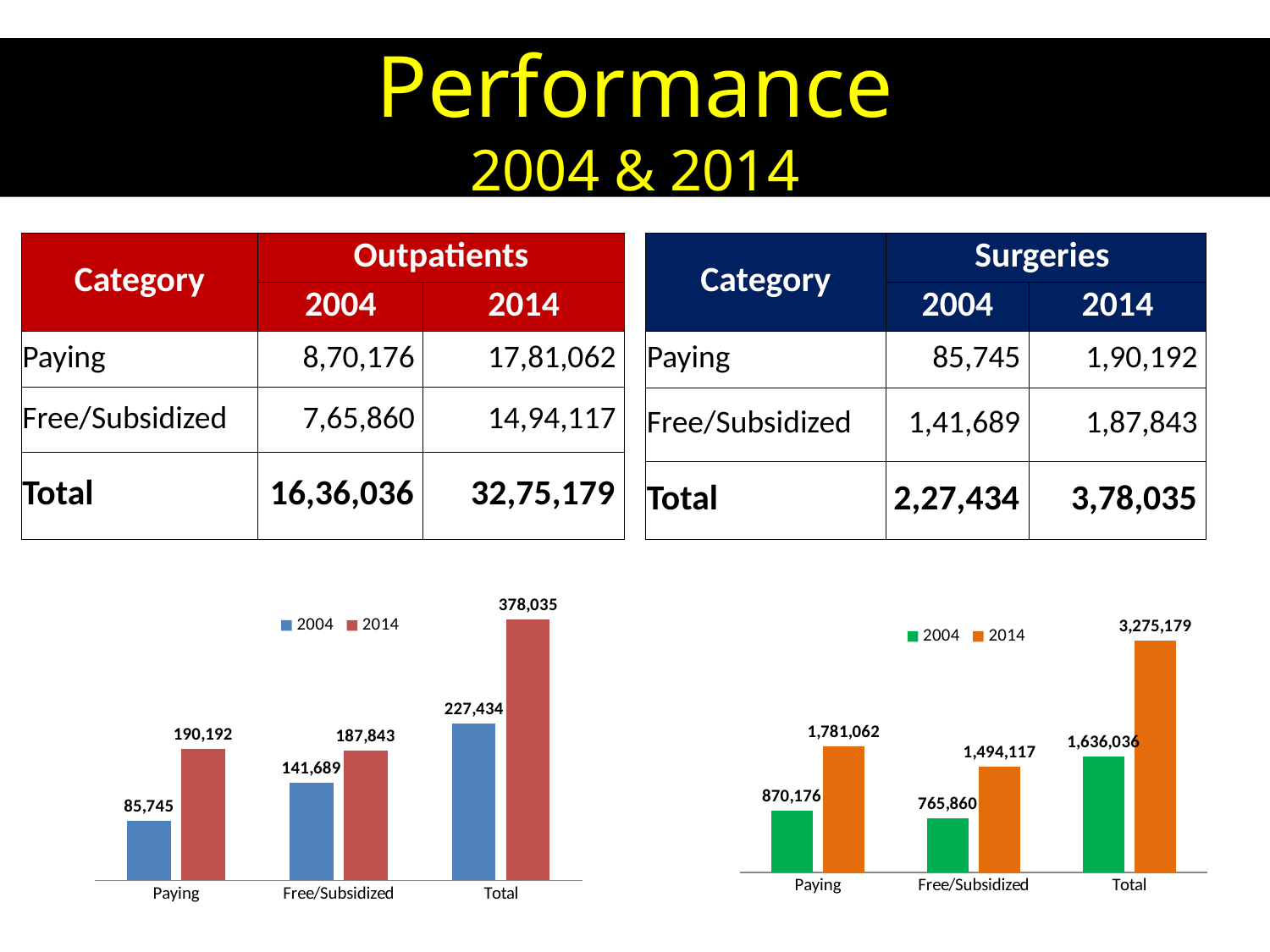
In the left chart, which is larger for 2004: Paying or Free/Subsidized? Free/Subsidized In the right chart, what is the value of the 2014 bar for Paying? 1,781,062 What type of chart is the right chart? Bar chart In the right chart, which category has the highest 2014 value? Total In the right chart, what is the difference between the 2014 and 2004 values for Paying? 910,886 In the left chart, what is the difference between the 2014 and 2004 values for Total? 150,601 How many categories are shown on the x axis of the right chart? 3 In the left chart, what is the value of the 2014 bar for Free/Subsidized? 187,843 In the right chart, what is the value of the 2004 bar for Free/Subsidized? 765,860 In the left chart, what is the value of the 2004 bar for Paying? 85,745 In the left chart, which category has the lowest 2004 value? Paying How many series does the legend of the left chart list? 2